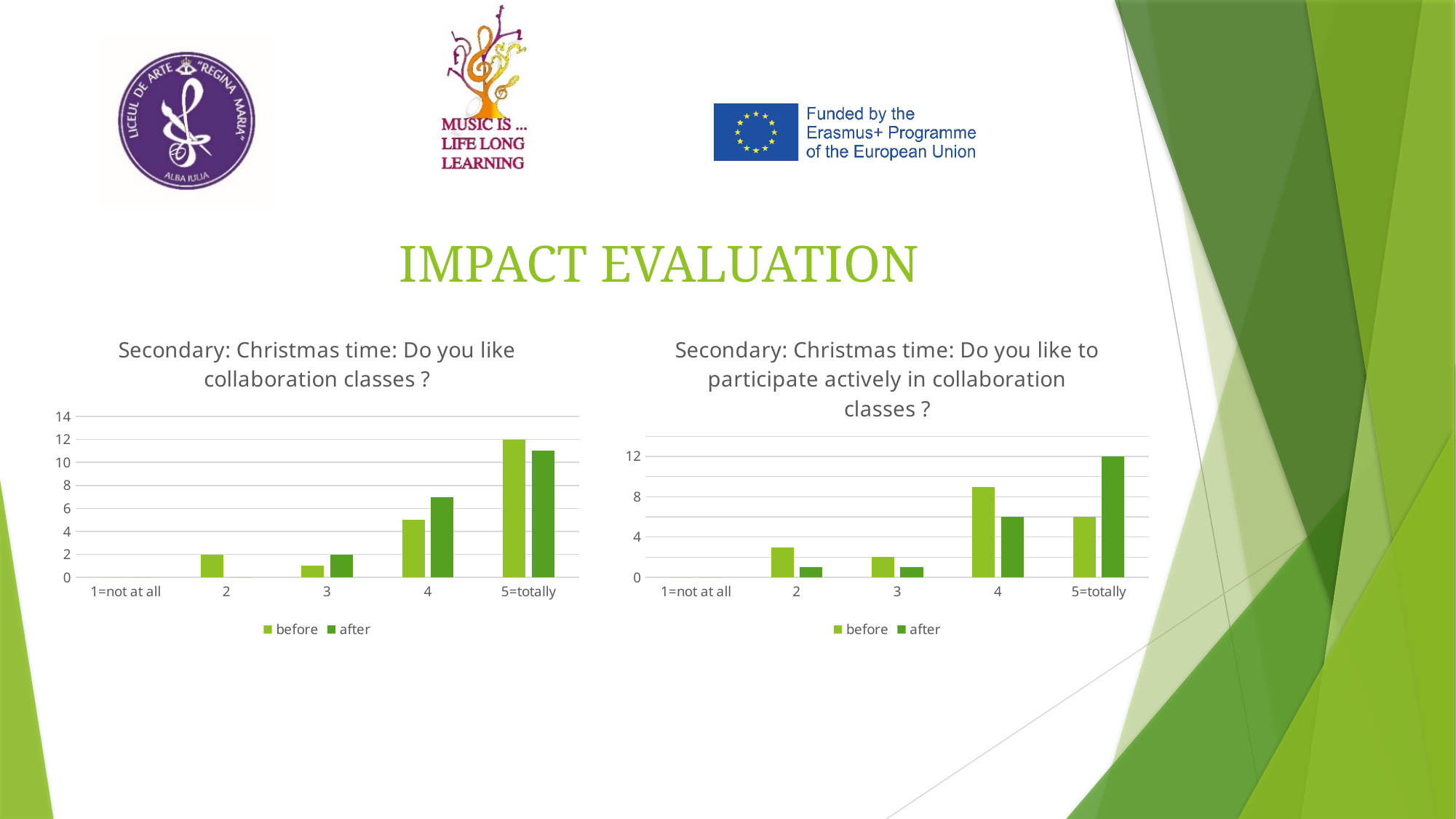
On the right chart (Do you like to participate actively in collaboration classes?), what is the 'after' value for 5=totally? 12 On the right chart (Do you like to participate actively in collaboration classes?), for 5=totally, which is larger: 'before' or 'after'? after On the left chart (Do you like collaboration classes?), what is the difference between the 'before' values for 5=totally and category 2? 10 On the right chart (Do you like to participate actively in collaboration classes?), is the 'after' value for category 4 greater or less than 8? less On the left chart (Do you like collaboration classes?), what is the 'before' value for category 2? 2 How many series does the legend of the left chart list? 2 On the left chart (Do you like collaboration classes?), which category has the highest 'before' value? 5=totally On the right chart (Do you like to participate actively in collaboration classes?), is the 'before' value for category 4 greater or less than 8? greater On the right chart (Do you like to participate actively in collaboration classes?), which category has the highest 'after' value? 5=totally On the left chart (Do you like collaboration classes?), what is the 'before' value for 5=totally? 12 What kind of chart is the right chart (Do you like to participate actively in collaboration classes?)? bar chart On the left chart (Do you like collaboration classes?), is the 'after' value for 5=totally greater or less than 10? greater